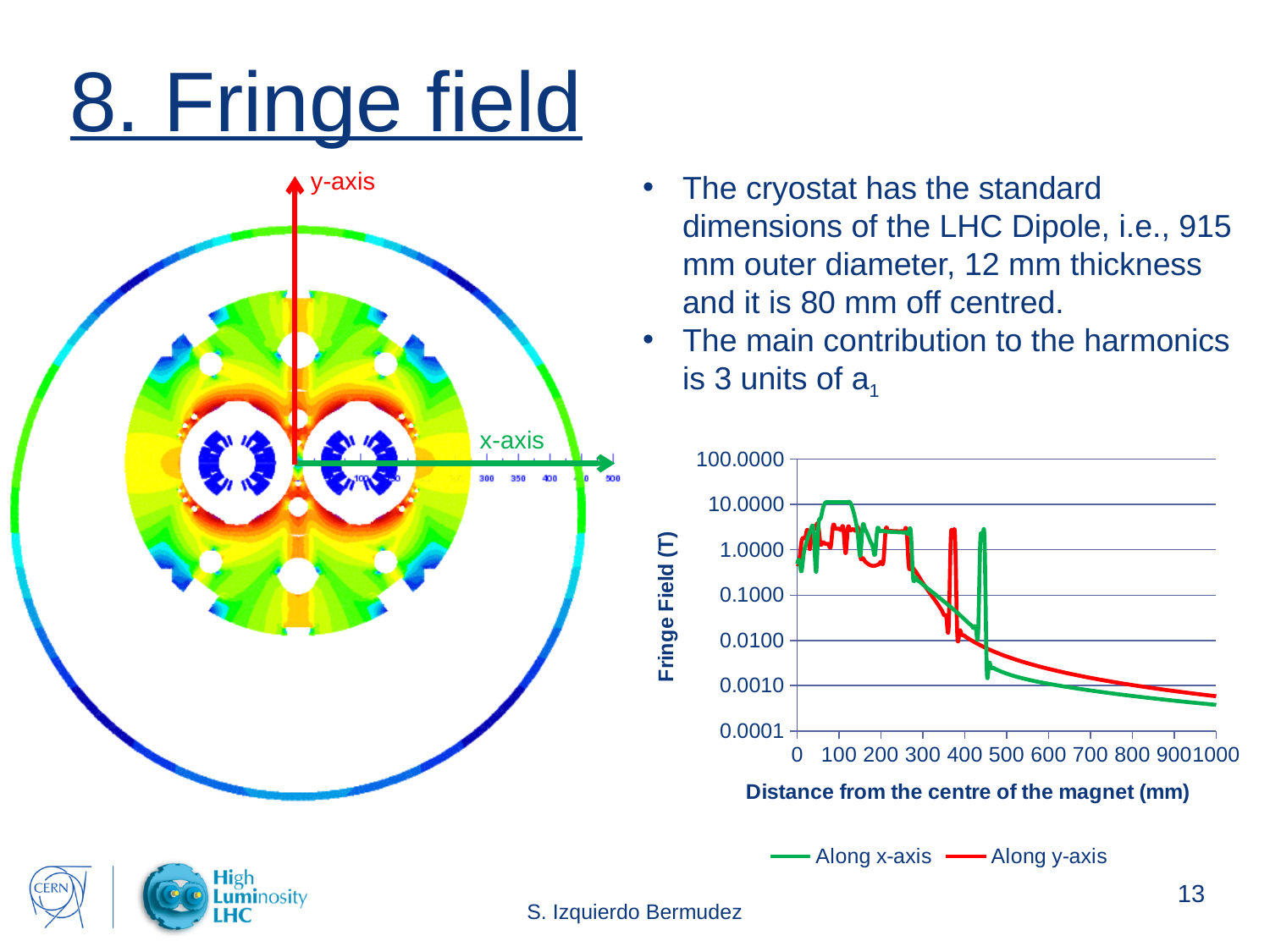
How many series does the legend of the fringe field chart list? 2 In the fringe field chart, do the values rise or fall between 500 mm and 1000 mm? fall In the fringe field chart, is the value for Along x-axis at 1000 mm greater or less than 0.0010? less In the fringe field chart, is the value for Along y-axis at 100 mm greater or less than 10.0000? less In the fringe field chart, is the value for Along y-axis at 1000 mm greater or less than 0.0010? less In the fringe field chart, which series has the higher value at 100 mm, Along x-axis or Along y-axis? Along x-axis What is the title of the vertical axis of the fringe field chart? Fringe Field (T) What is the highest tick value shown on the vertical axis of the fringe field chart? 100.0000 In the fringe field chart, which series has the higher value at 800 mm, Along x-axis or Along y-axis? Along y-axis What kind of chart is shown on the right of the slide? Line chart In the fringe field chart, which series is drawn in green? Along x-axis